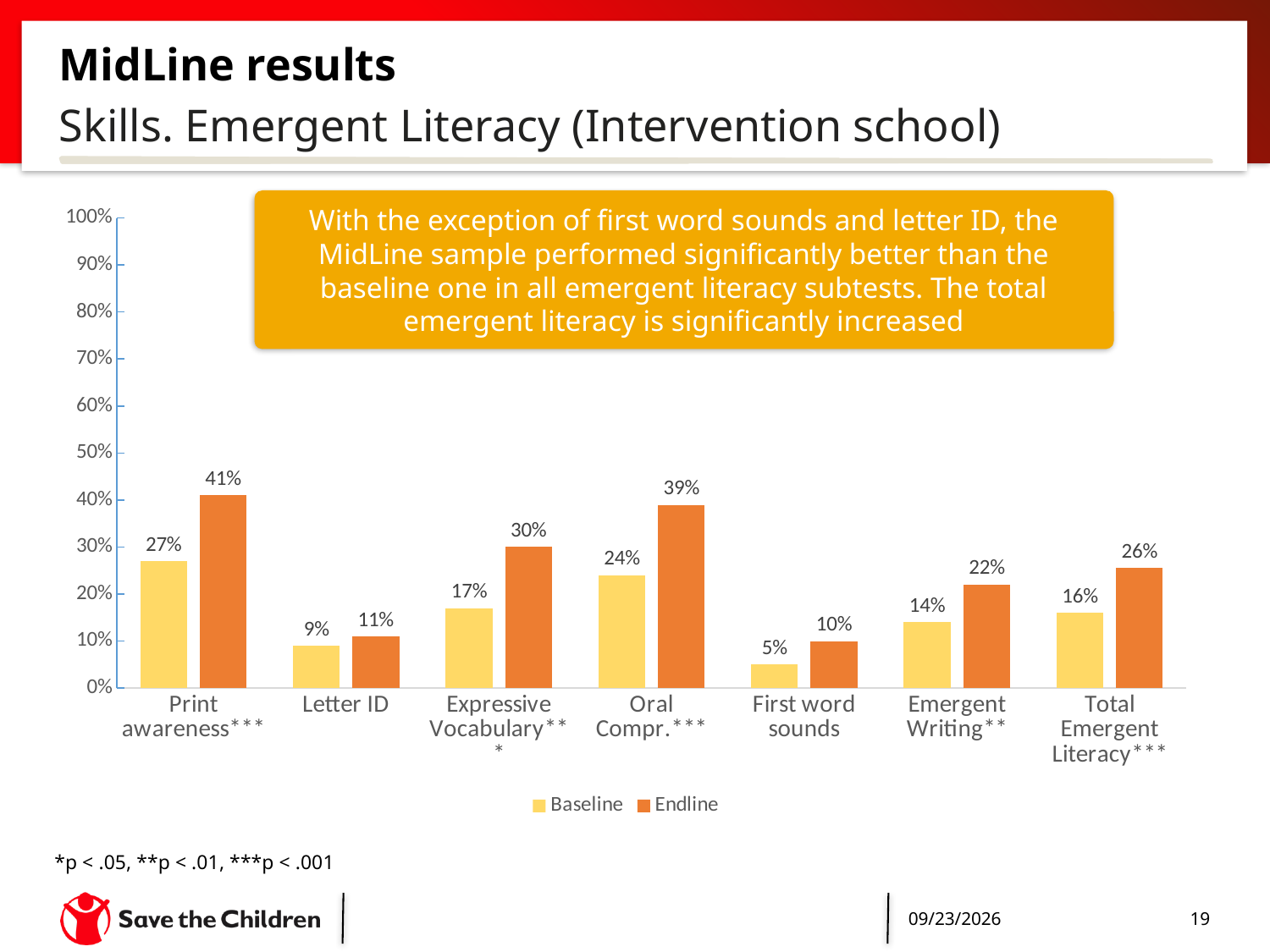
How many categories are shown on the x axis? 7 What is the Baseline value for First word sounds? 5% What is the Endline value for Print awareness? 41% How many series does the legend list? 2 Which is larger: the Endline value for Expressive Vocabulary or the Endline value for Emergent Writing? Expressive Vocabulary Which category has the lowest Baseline value? First word sounds Which category has the highest Endline value? Print awareness What is the difference between the Endline and Baseline values for Letter ID? 2% What is the difference between the Endline and Baseline values for Oral Compr.? 15% What is the Baseline value for Oral Compr.? 24% What kind of chart is shown on the slide? Bar chart What is the Endline value for Total Emergent Literacy? 26%